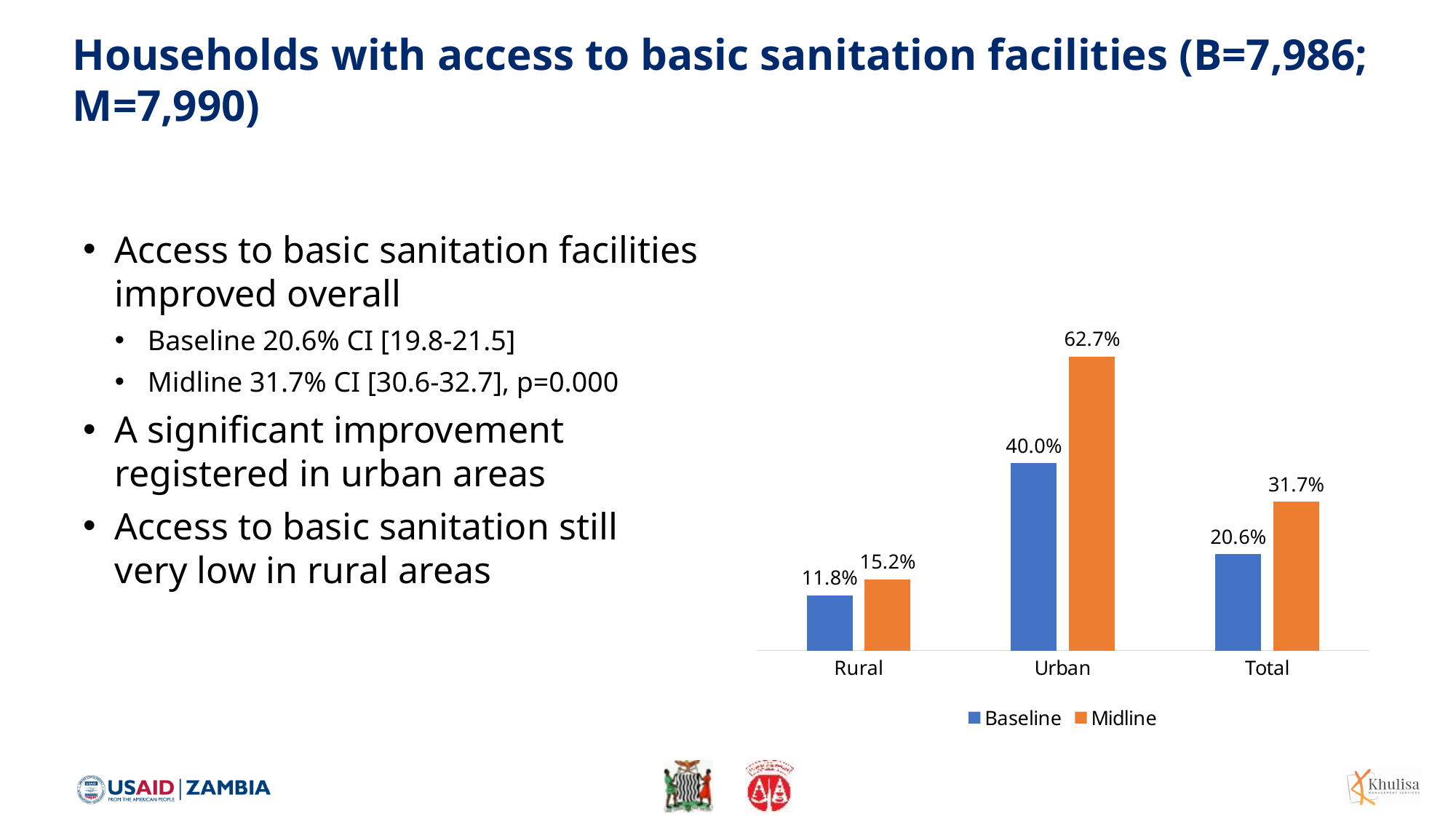
What is the Baseline value for Urban? 40.0% What is the Midline value for Urban? 62.7% How many categories are shown on the x axis? 3 What kind of chart is shown on the slide? Bar chart Which is larger, the Baseline value for Urban or the Midline value for Total? Baseline value for Urban Which category has the lowest Baseline value? Rural What is the Baseline value for Rural? 11.8% Which category has the highest Midline value? Urban What is the difference between the Midline and Baseline values for Urban? 22.7% What is the difference between the Midline and Baseline values for Rural? 3.4% How many series does the legend list? 2 What is the Midline value for Total? 31.7%